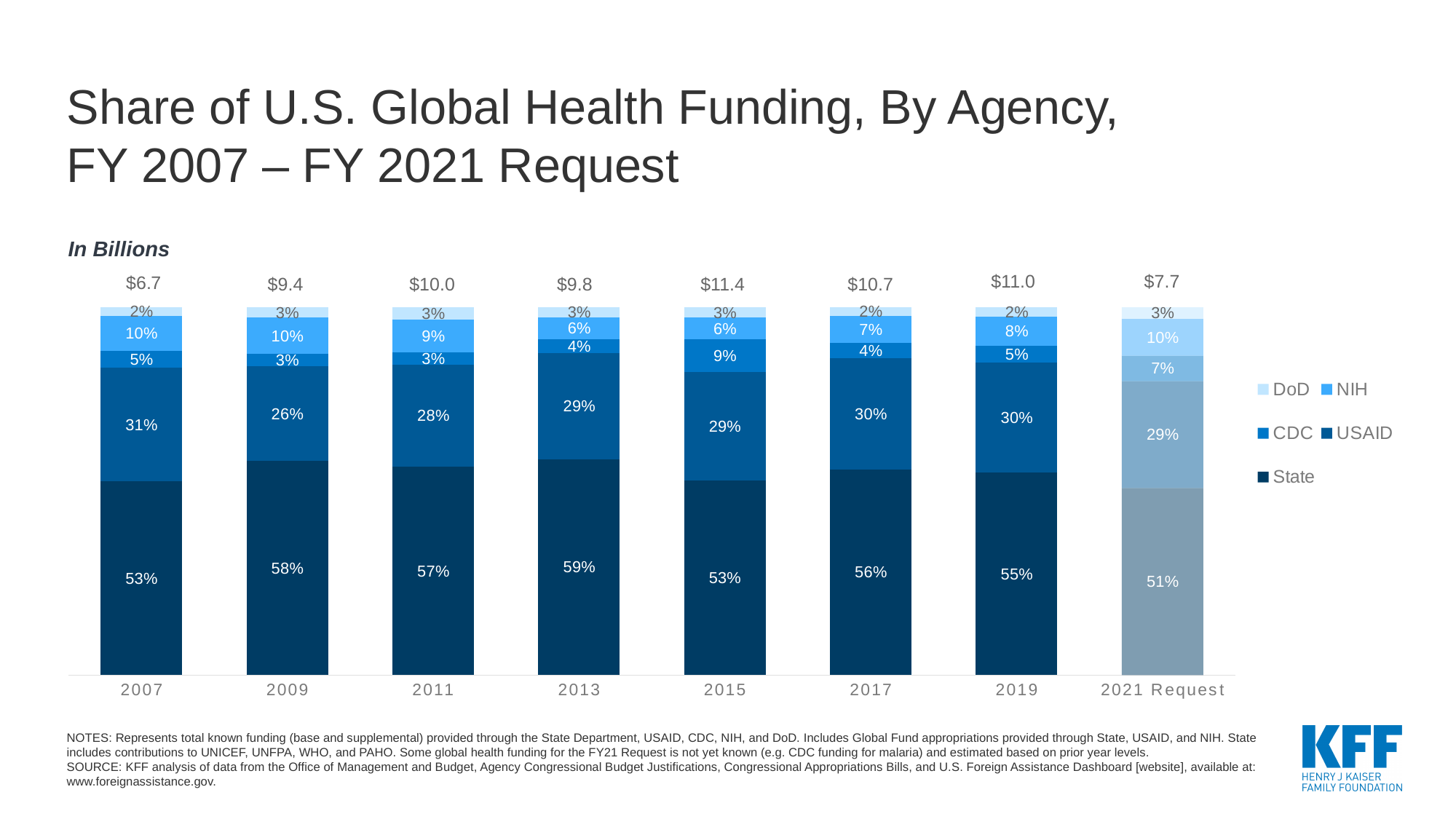
How many percentage points higher is State's share in 2013 than in the 2021 Request? 8 percentage points What share of funding is shown for NIH in the 2021 Request? 10% What share of funding is shown for USAID in 2017? 30% How many agencies does the legend list? 5 What share of funding is shown for CDC in 2015? 9% What total funding amount is shown above the 2015 bar? $11.4 Which year has the lowest total funding amount shown above its bar? 2007 What share of U.S. global health funding went to State in 2007? 53% What kind of chart is shown on the slide? Stacked bar chart Which year has the highest total funding amount shown above its bar? 2015 Which is larger, the NIH share in 2007 or the NIH share in 2013? 2007 How many bars (years) are shown in the chart? 8